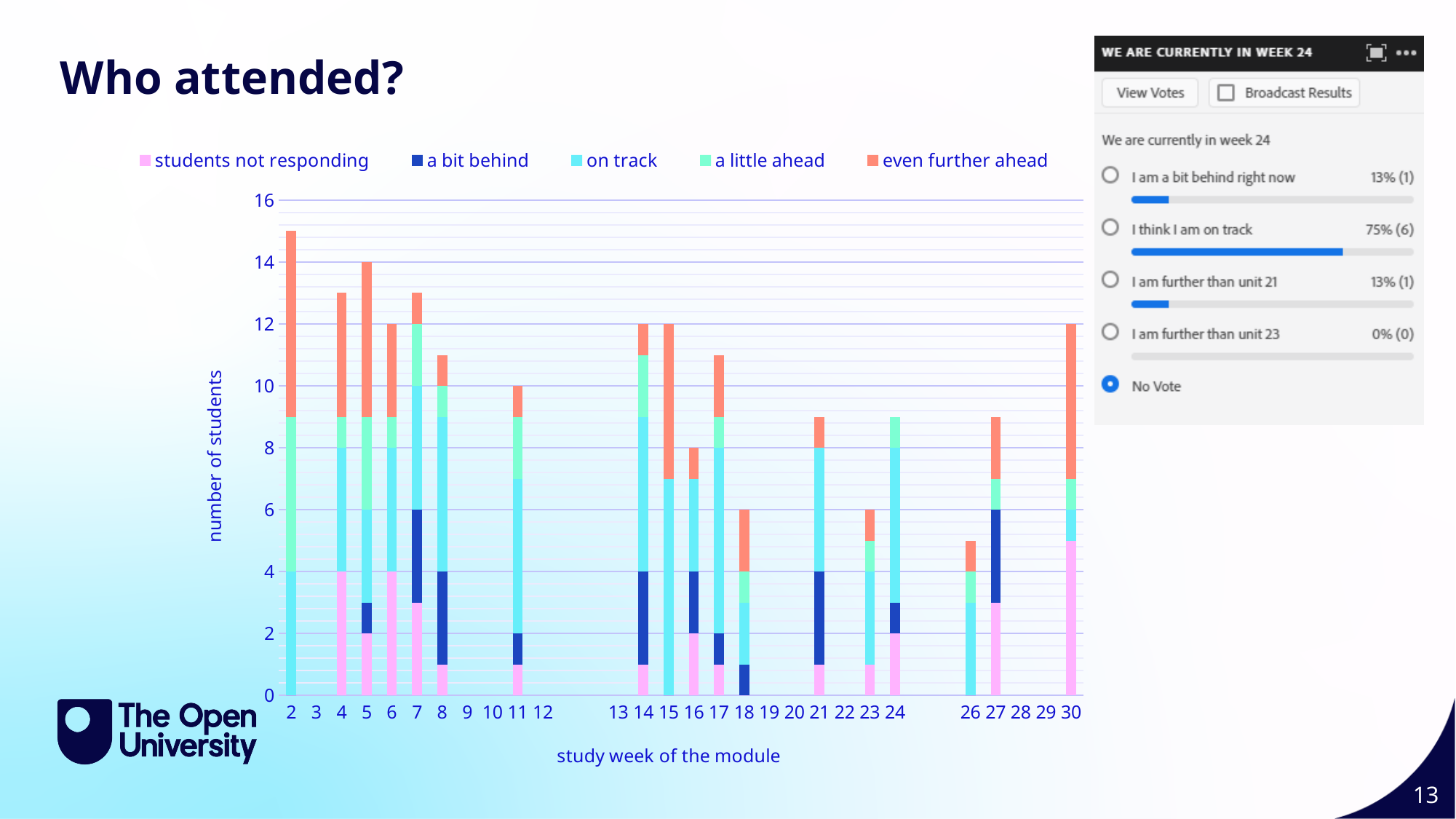
Which has a taller bar, study week 14 or study week 18? study week 14 What is the total number of students for study week 16? 8 What kind of chart is shown on the slide? stacked bar chart Is the total number of students for study week 2 greater or less than 14? greater Is the total number of students for study week 26 greater or less than 6? less Which study week has the tallest bar in the chart? 2 What is the label of the vertical axis of the chart? number of students What is the total number of students for study week 5? 14 Is the total number of students for study week 8 greater or less than 10? greater How many series does the chart legend list? 5 What is the total number of students for study week 30? 12 What is the label of the horizontal axis of the chart? study week of the module